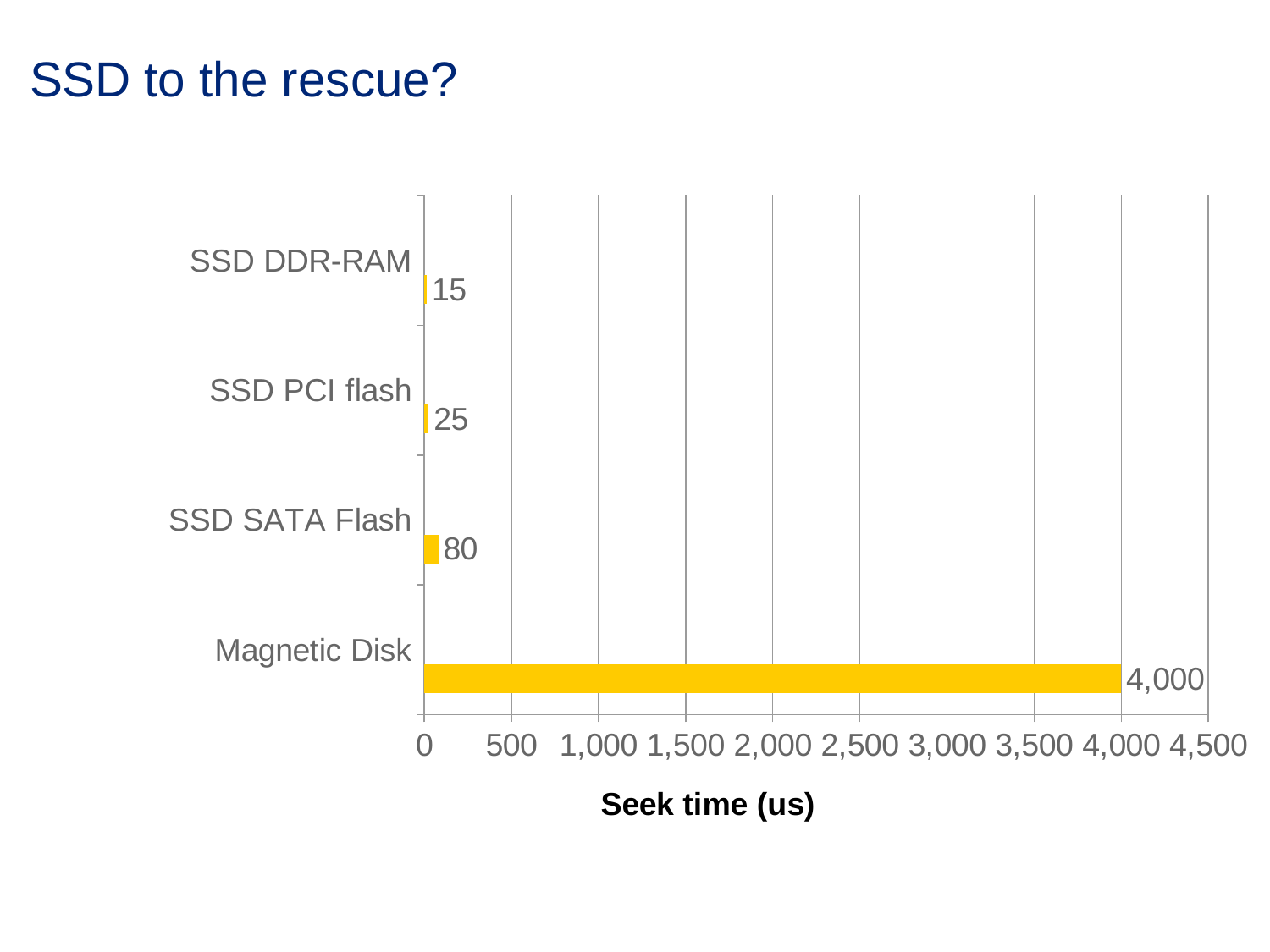
What is the seek time for SSD PCI flash? 25 How many categories are shown in the chart? 4 Which category has the lowest seek time? SSD DDR-RAM Which category has the highest seek time? Magnetic Disk What is the difference in seek time between Magnetic Disk and SSD SATA Flash? 3,920 What type of chart is shown on the slide? Bar chart What is the seek time for Magnetic Disk? 4,000 What is the seek time for SSD SATA Flash? 80 What is the label of the horizontal axis? Seek time (us) What is the seek time for SSD DDR-RAM? 15 What is the difference in seek time between SSD SATA Flash and SSD PCI flash? 55 Which has a larger seek time, SSD PCI flash or SSD DDR-RAM? SSD PCI flash